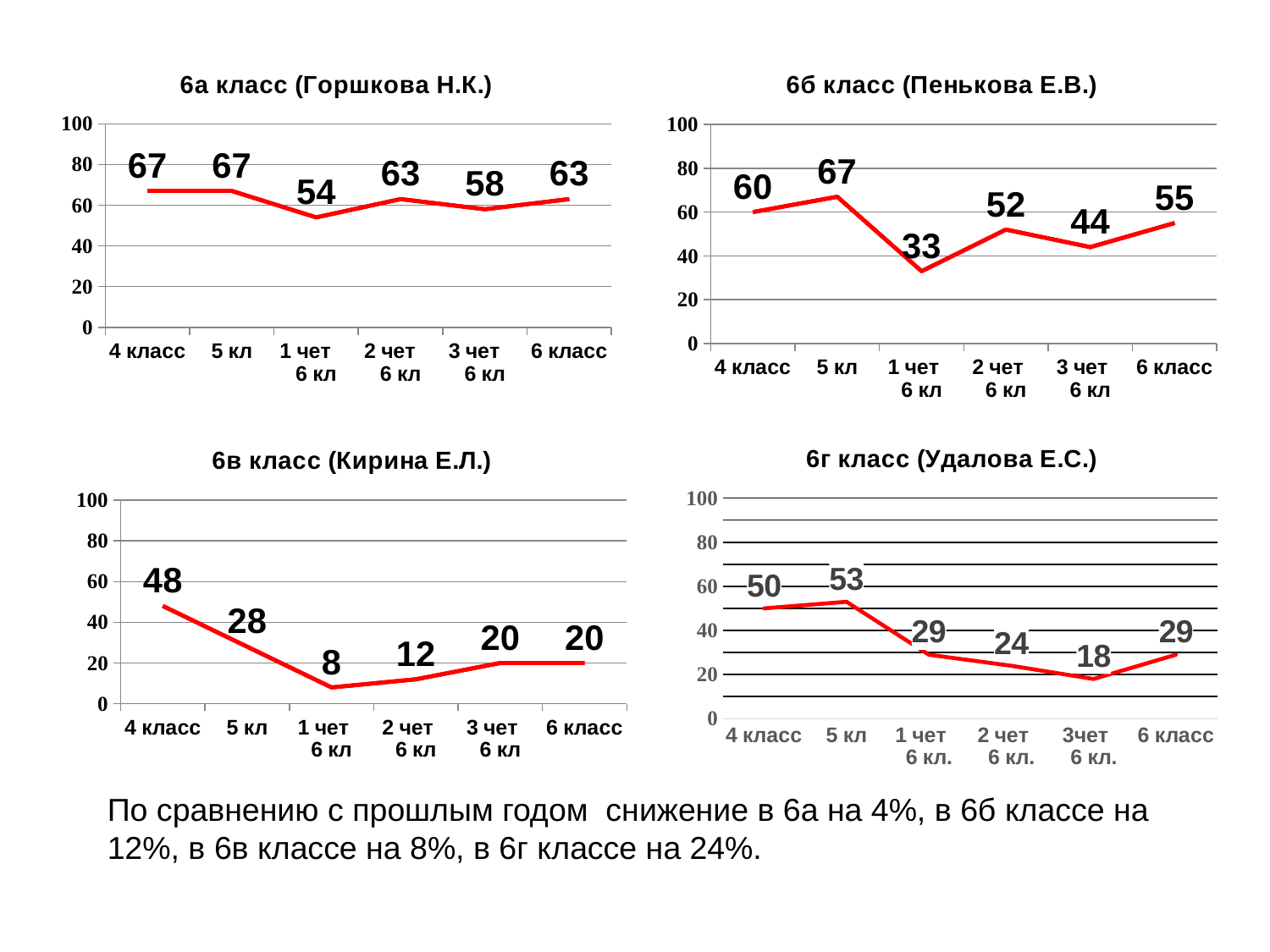
What type of chart is the chart titled "6б класс (Пенькова Е.В.)"? line chart In the chart titled "6в класс (Кирина Е.Л.)", is the value for "5 кл" larger or smaller than the value for "6 класс"? larger In the chart titled "6а класс (Горшкова Н.К.)", which category has the highest value? 4 класс and 5 кл (both 67) In the chart titled "6в класс (Кирина Е.Л.)", do the values rise or fall from "4 класс" to "1 чет 6 кл"? fall In the chart titled "6б класс (Пенькова Е.В.)", which category has the lowest value? 1 чет 6 кл In the chart titled "6а класс (Горшкова Н.К.)", what is the value for "1 чет 6 кл"? 54 In the chart titled "6в класс (Кирина Е.Л.)", what is the value for "4 класс"? 48 In the chart titled "6г класс (Удалова Е.С.)", what is the difference between the values for "5 кл" and "6 класс"? 24 In the chart titled "6г класс (Удалова Е.С.)", how many data points are plotted? 6 How many charts are shown on the slide? 4 In the chart titled "6г класс (Удалова Е.С.)", what is the value for "3чет 6 кл."? 18 In the chart titled "6б класс (Пенькова Е.В.)", what is the difference between the values for "5 кл" and "1 чет 6 кл"? 34